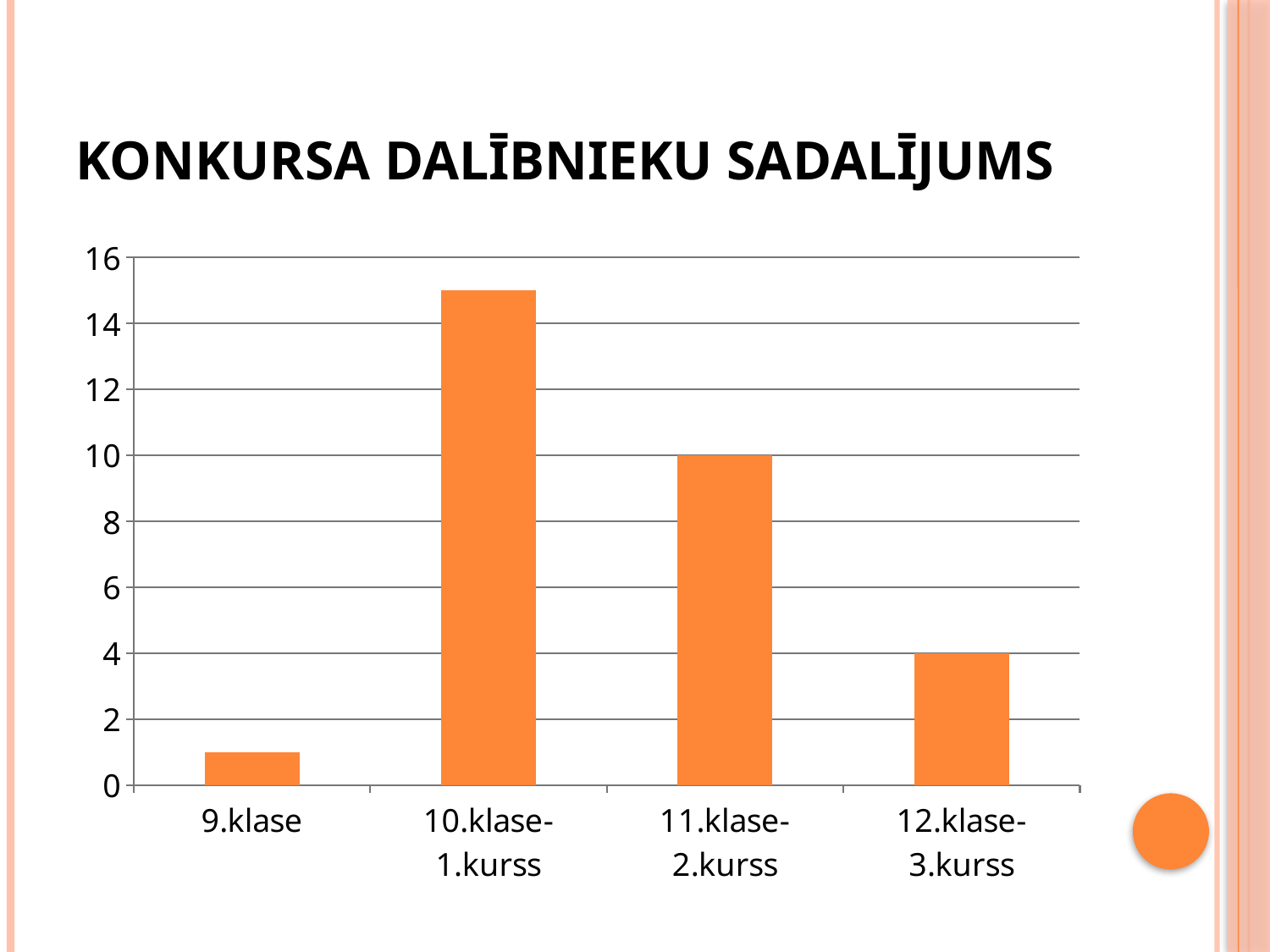
What is the value for 11.klase-2.kurss? 10 Which category has the highest value? 10.klase-1.kurss Which is larger, the value for 11.klase-2.kurss or the value for 12.klase-3.kurss? 11.klase-2.kurss What is the title of the chart? KONKURSA DALĪBNIEKU SADALĪJUMS Is the value for 10.klase-1.kurss greater or less than 14? greater What is the value for 12.klase-3.kurss? 4 Which category has the lowest value? 9.klase What kind of chart is shown on the slide? bar chart What is the highest value shown on the vertical axis? 16 What is the difference between the values for 11.klase-2.kurss and 12.klase-3.kurss? 6 How many categories are shown on the x axis? 4 Is the value for 9.klase greater or less than 2? less